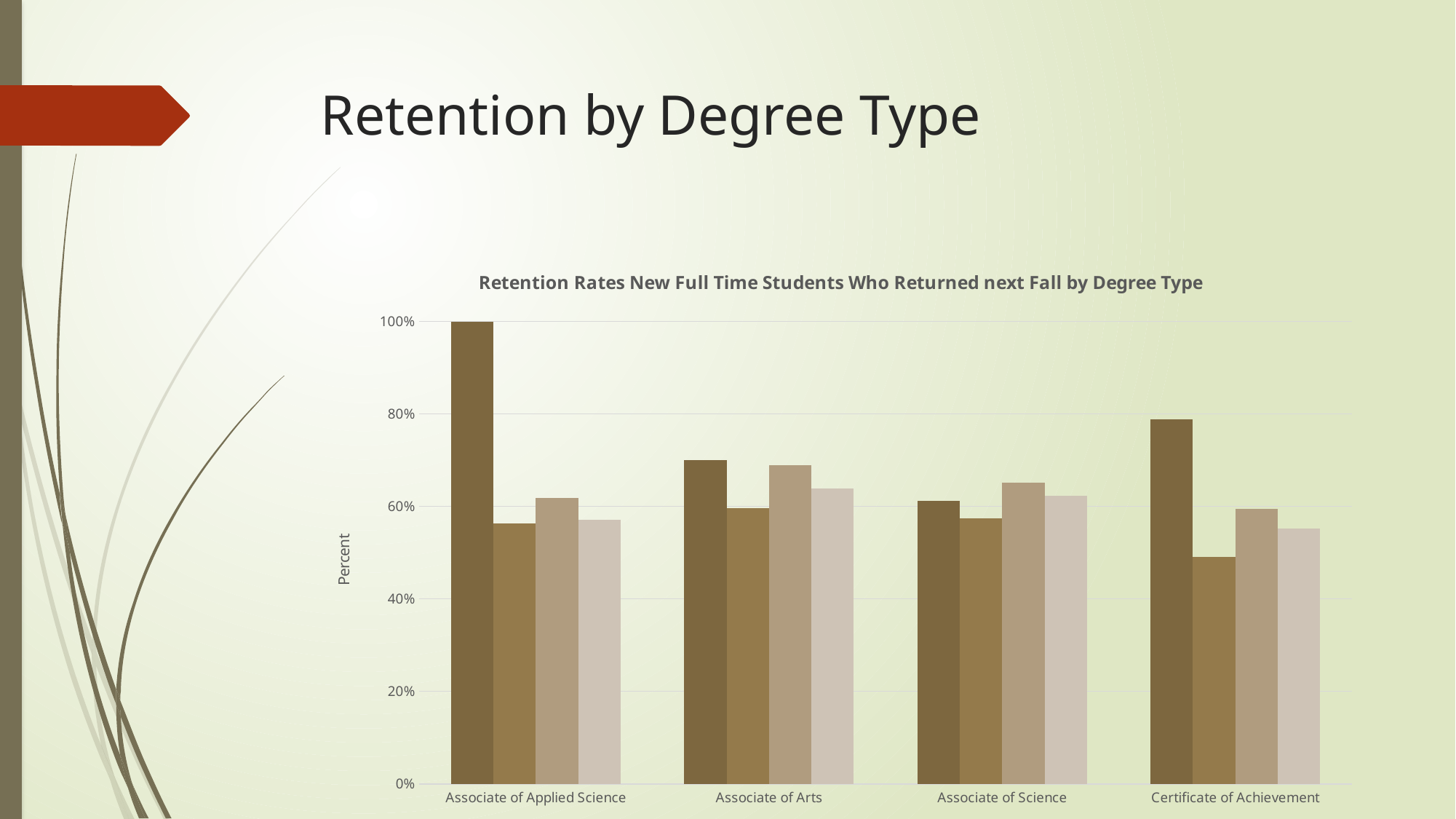
Which is larger: the first bar for Associate of Applied Science or the first bar for Associate of Science? Associate of Applied Science What is the label on the vertical axis of the chart? Percent Which degree type category contains the tallest bar in the chart? Associate of Applied Science Is the value of the first (leftmost) bar for Certificate of Achievement greater or less than 60%? greater How many degree type categories are shown on the x axis? 4 What is the title of the chart? Retention Rates New Full Time Students Who Returned next Fall by Degree Type What is the value of the tallest bar in the Associate of Applied Science group? 100% How many bars are plotted for each degree type category? 4 Is the value of the first (leftmost) bar for Associate of Arts greater or less than 60%? greater Is the value of the second bar for Associate of Applied Science greater or less than 60%? less What type of chart is shown on the slide? bar chart